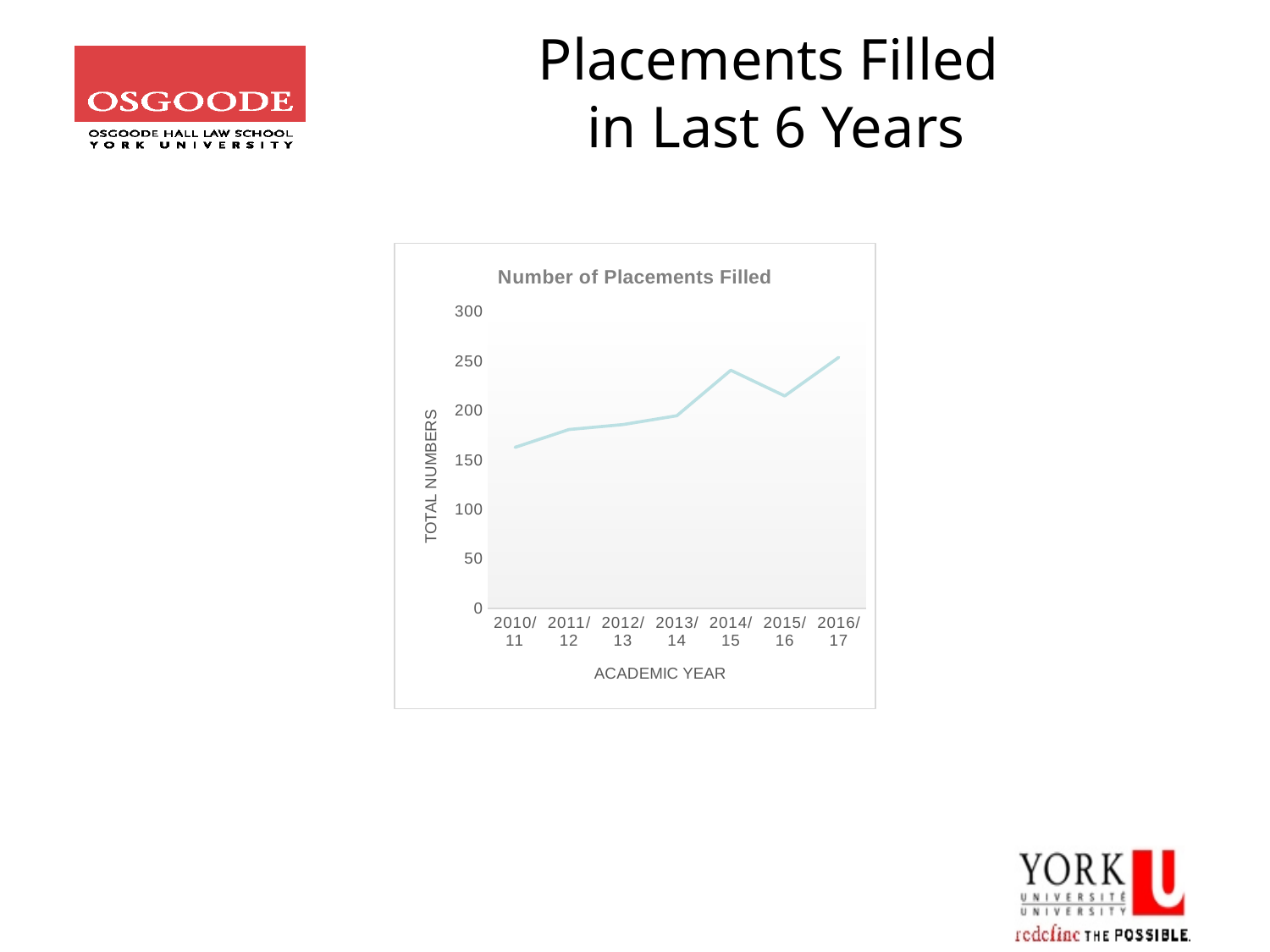
What is the label of the vertical axis of the chart? TOTAL NUMBERS Which academic year has the lowest number of placements filled? 2010/11 Is the value for 2010/11 greater or less than 150? greater What kind of chart is shown on the slide? Line chart Which is larger, the value for 2014/15 or the value for 2015/16? 2014/15 Overall, do the values rise or fall from 2010/11 to 2016/17? rise Is the value for 2015/16 greater or less than 200? greater How many academic years are plotted on the x axis? 7 What is the title of the chart? Number of Placements Filled Which is larger, the value for 2010/11 or the value for 2013/14? 2013/14 Is the value for 2011/12 greater or less than 200? less Which academic year has the highest number of placements filled? 2016/17